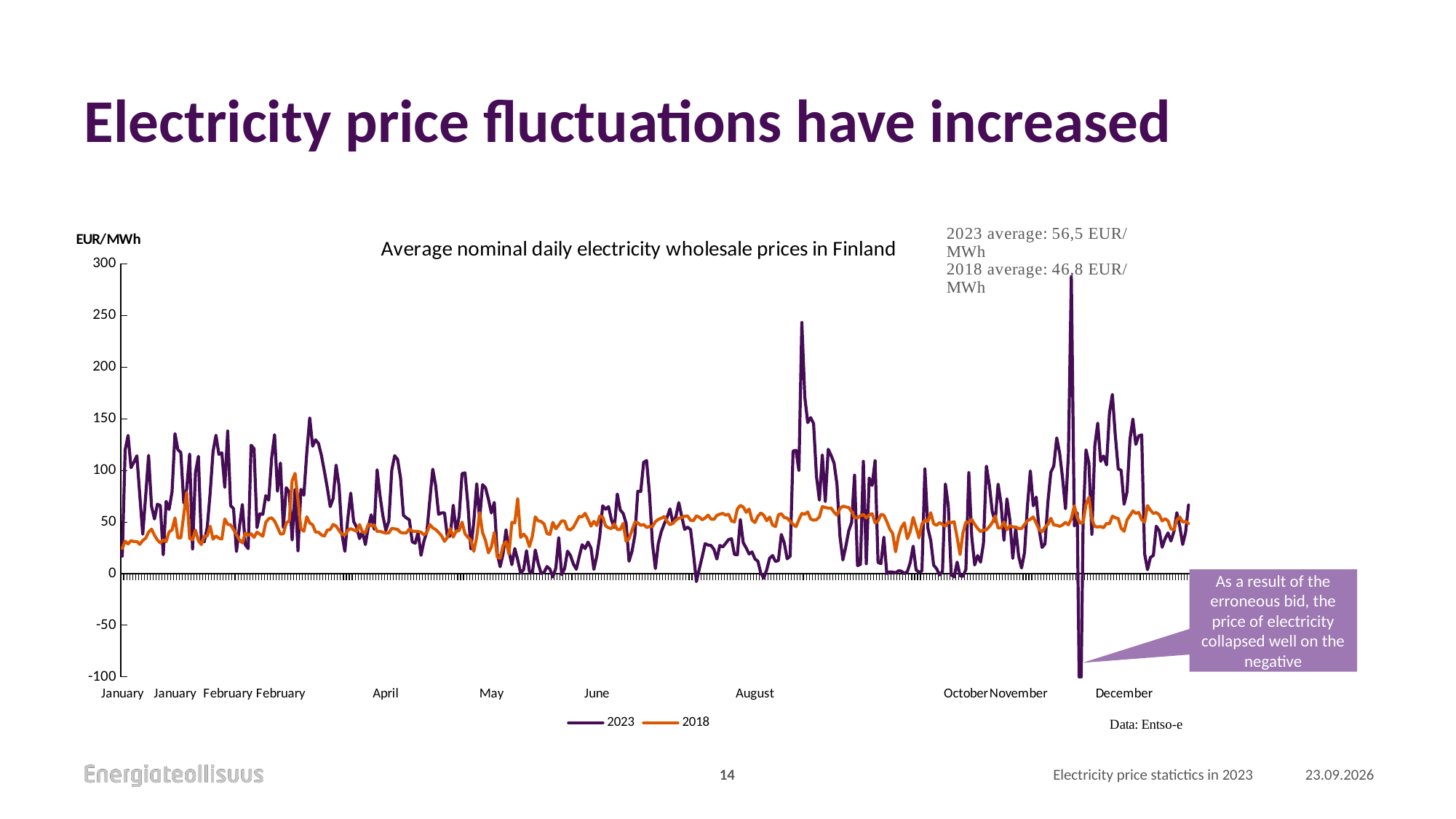
What is the 2023 average price stated on the slide? 56,5 EUR/MWh Which two years are shown in the chart's legend? 2023 and 2018 What is the title of the chart? Average nominal daily electricity wholesale prices in Finland What is the data source cited for the chart? Entso-e What is the 2018 average price stated on the slide? 46,8 EUR/MWh Is the lowest value of the 2023 series (the late-November dip) greater or less than -50? less Does the 2018 series ever rise above 150 EUR/MWh? No By how much does the 2023 average price exceed the 2018 average price? 9,7 EUR/MWh What kind of chart is shown on the slide? Line chart Is the highest value of the 2023 series (the December spike) greater or less than 250? greater Which year has the higher average price according to the slide, 2023 or 2018? 2023 How many series does the legend of the chart list? 2